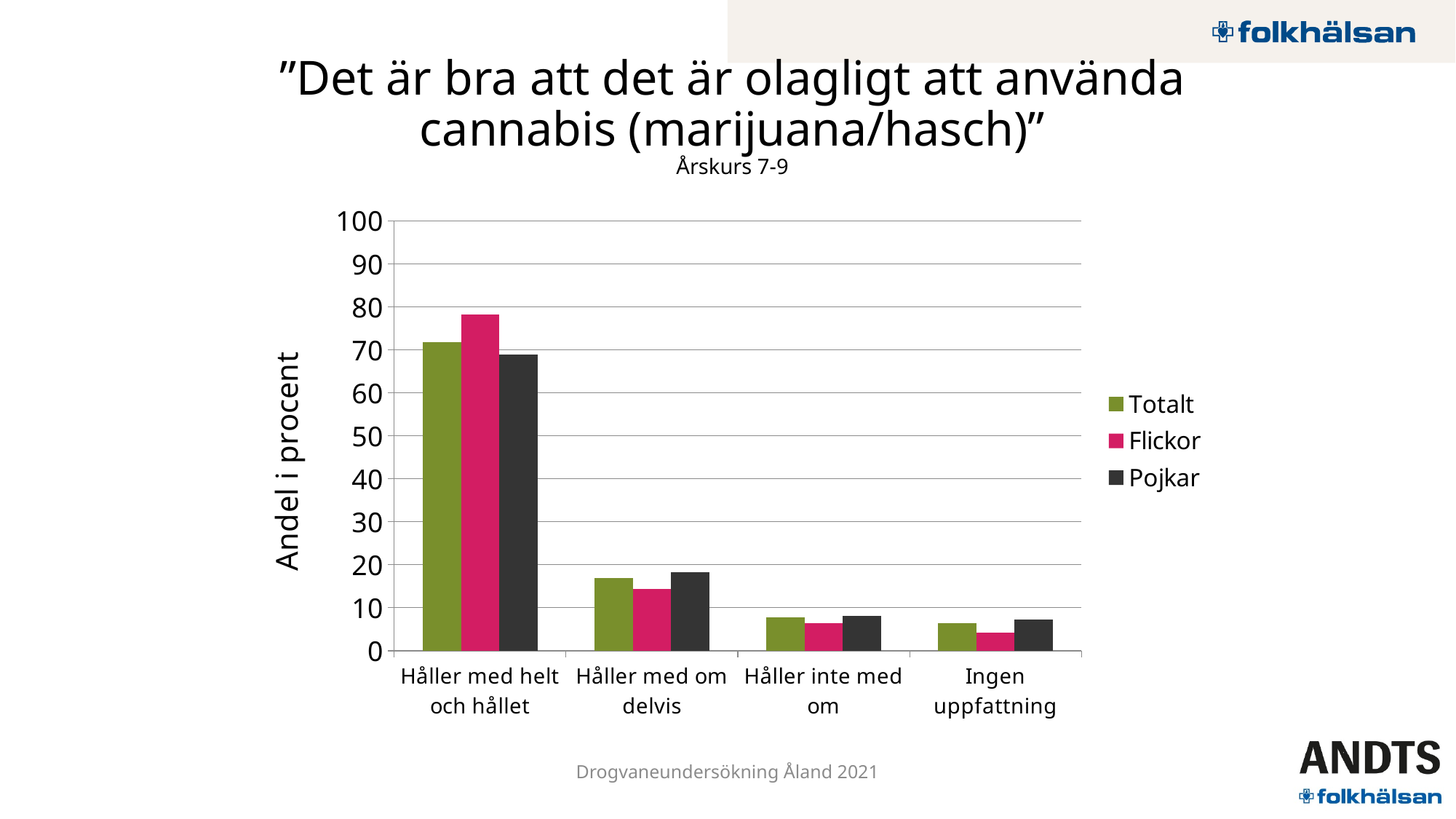
Is the value for Totalt in 'Håller med om delvis' greater or less than 20? less For the Flickor series, which category has the highest value? Håller med helt och hållet What are the entries in the legend? Totalt, Flickor, Pojkar In the category 'Håller med helt och hållet', which is larger: Flickor or Pojkar? Flickor How many series does the legend list? 3 Is the value for Flickor in 'Håller med helt och hållet' greater or less than 70? greater For the Flickor series, which category has the lowest value? Ingen uppfattning Do the values for the Totalt series rise or fall from left to right along the x axis? fall In the category 'Håller med om delvis', which is larger: Flickor or Pojkar? Pojkar What kind of chart is shown on the slide? Bar chart What is the title of the y axis? Andel i procent How many categories are shown on the x axis? 4